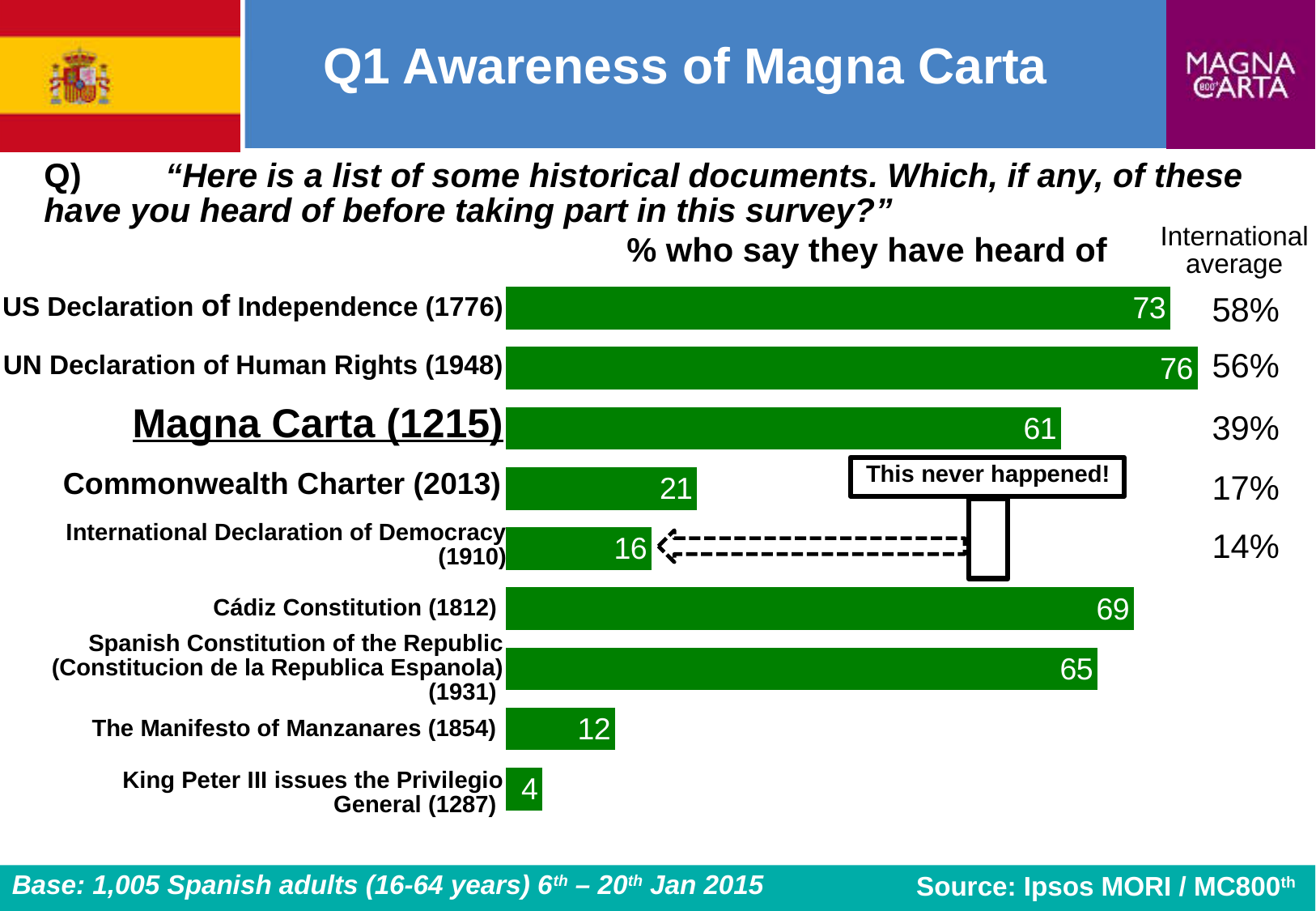
Which document has the highest percentage of people who say they have heard of it? UN Declaration of Human Rights (1948) Which has a higher value: the Commonwealth Charter (2013) or the International Declaration of Democracy (1910)? Commonwealth Charter (2013) How many documents are listed in the chart? 9 What percentage say they have heard of the Cádiz Constitution (1812)? 69 What is the difference between the percentage who have heard of the US Declaration of Independence (1776) and the Magna Carta (1215)? 12 What kind of chart is shown on the slide? Bar chart What is the difference between the Spanish value and the international average for the Commonwealth Charter (2013)? 4 Which document has the lowest percentage of people who say they have heard of it? King Peter III issues the Privilegio General (1287) What is the value shown for King Peter III issues the Privilegio General (1287)? 4 What is the international average shown for the Magna Carta (1215)? 39% What percentage of Spanish adults say they have heard of the Magna Carta (1215)? 61 What does the annotation box next to the International Declaration of Democracy (1910) bar say? This never happened!